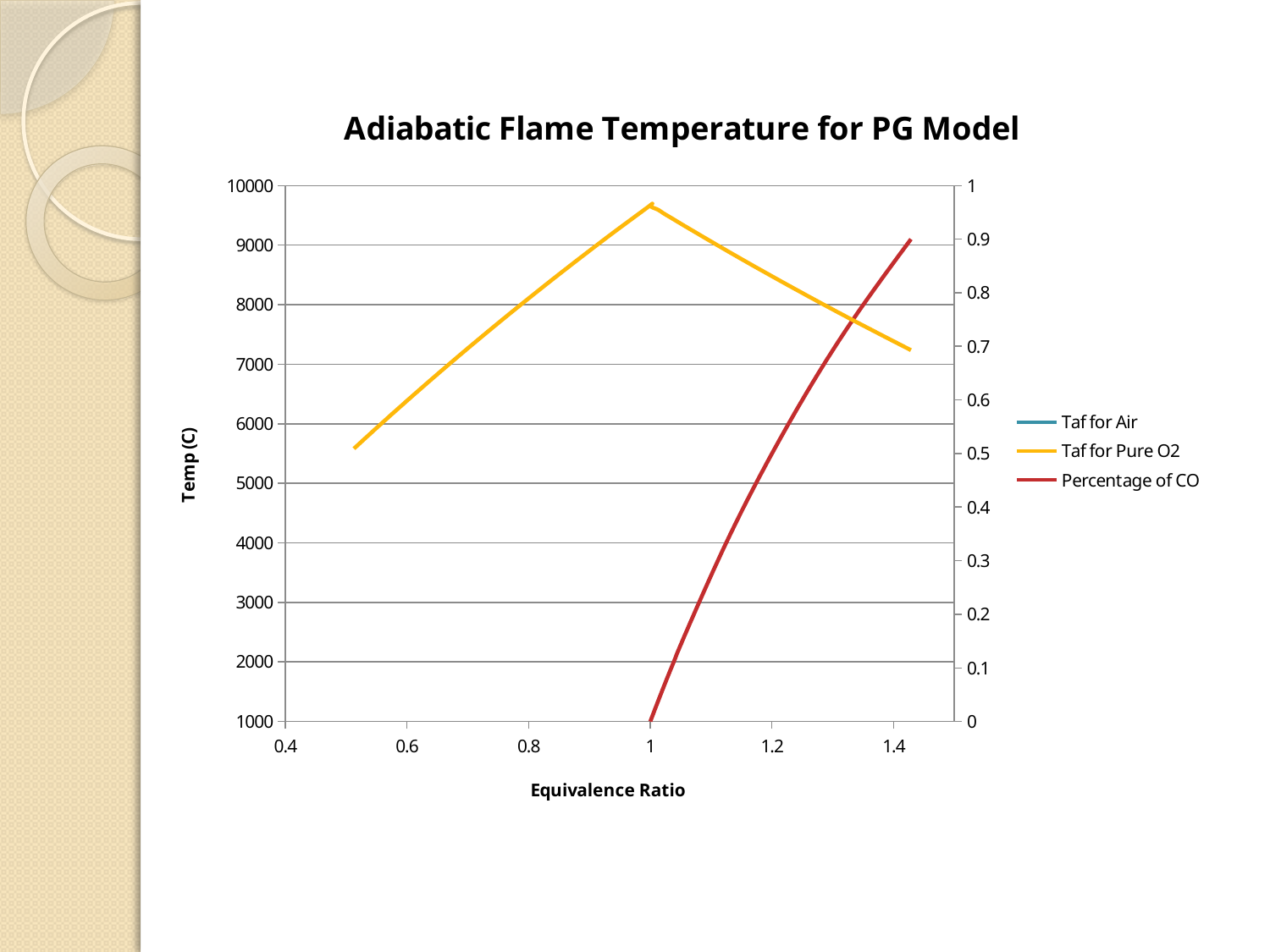
Is the Percentage of CO value at an equivalence ratio of 1.2 greater or less than 0.4? greater Is the Taf for Pure O2 value at an equivalence ratio of 0.6 greater or less than 7000? less Does the Taf for Pure O2 line rise or fall as the equivalence ratio increases from 1 to 1.4? fall At which equivalence ratio does the Taf for Pure O2 line reach its highest value? 1 How many series does the legend list? 3 What is the Percentage of CO value at an equivalence ratio of 1? 0 What kind of chart is shown on the slide? line chart What is the label of the x axis? Equivalence Ratio Is the Taf for Pure O2 value at an equivalence ratio of 1 greater or less than 9000? greater What is the title of the chart? Adiabatic Flame Temperature for PG Model Does the Percentage of CO line rise or fall as the equivalence ratio increases from 1 to 1.4? rise